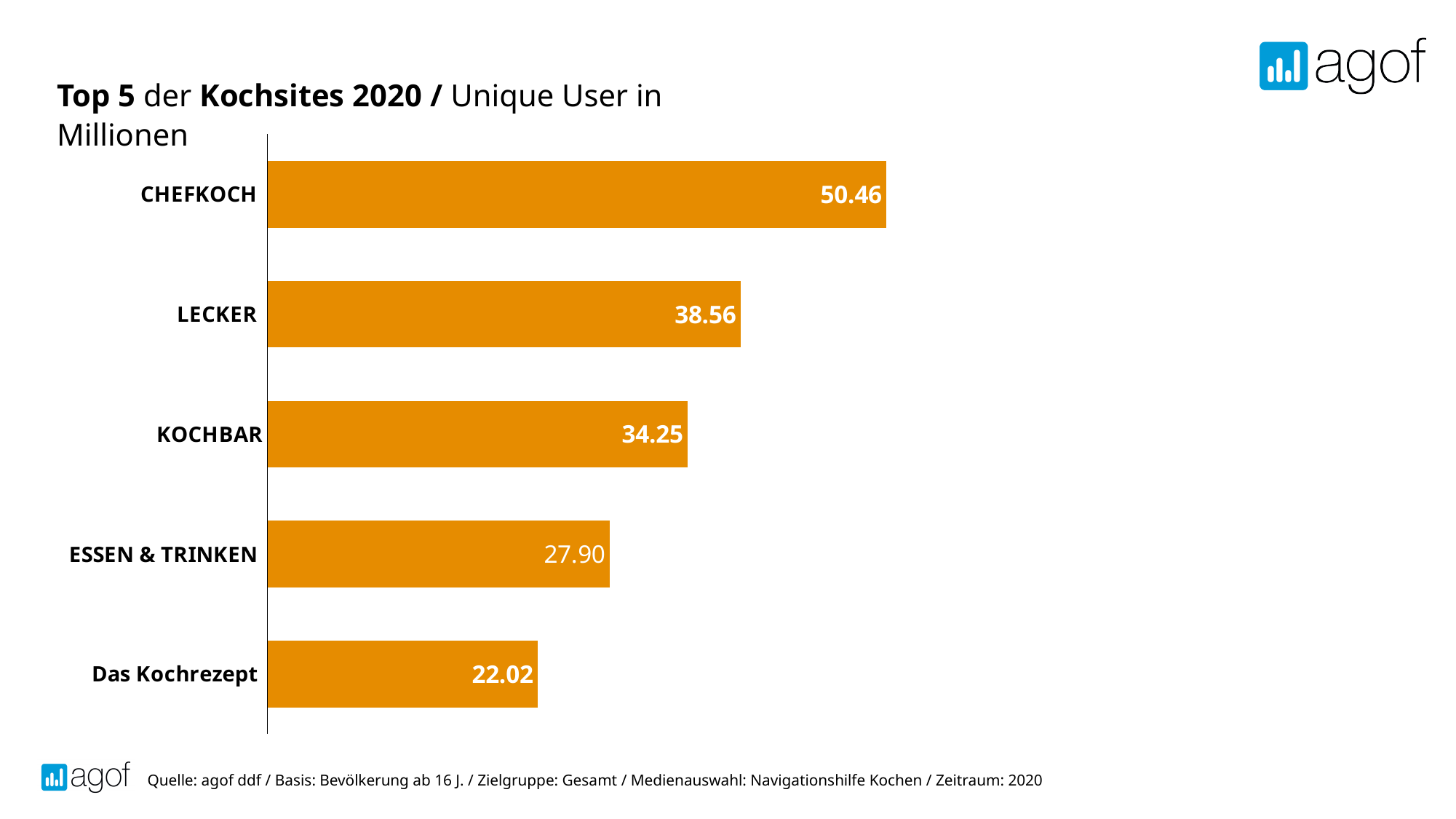
What is the difference between the values for CHEFKOCH and LECKER? 11.90 How many sites are shown in the chart? 5 What is the value for LECKER? 38.56 What kind of chart is shown on the slide? bar chart Which is larger, the value for KOCHBAR or the value for ESSEN & TRINKEN? KOCHBAR What is the value for KOCHBAR? 34.25 What is the value for Das Kochrezept? 22.02 What is the title of the chart? Top 5 der Kochsites 2020 / Unique User in Millionen Which site has the highest number of unique users? CHEFKOCH What is the value for ESSEN & TRINKEN? 27.90 Which site has the lowest number of unique users? Das Kochrezept What is the value for CHEFKOCH? 50.46